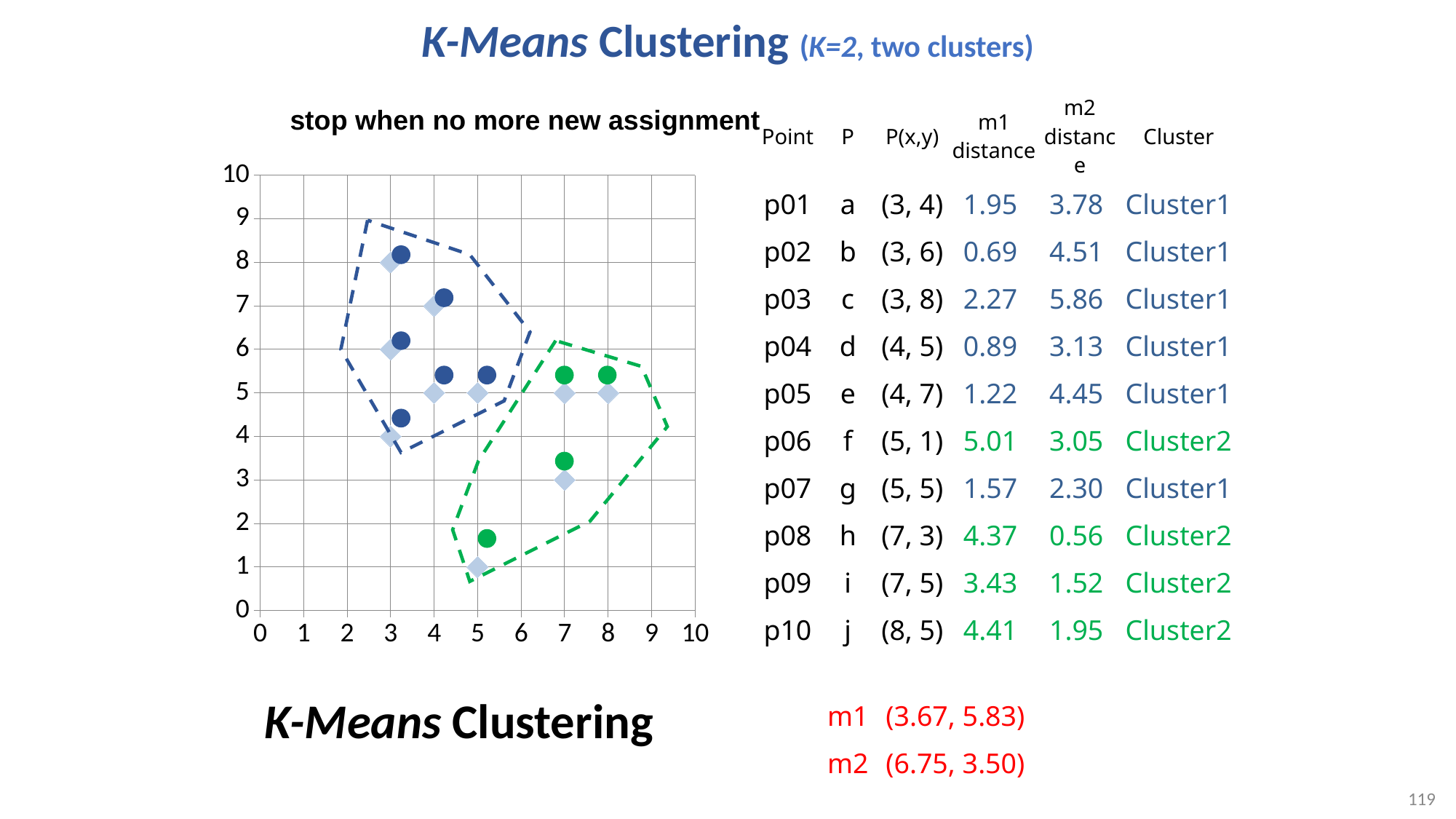
Which point has the lowest y value on the scatter chart? f (5, 1) Which point has the highest y value on the scatter chart? c (3, 8) What is the maximum value shown on the y axis of the scatter chart? 10 What kind of chart is shown on the left of the slide? scatter chart What are the coordinates of point c (p03) on the scatter chart? (3, 8) What are the coordinates of point j (p10) on the scatter chart? (8, 5) What is the difference in y value between point c (3, 8) and point a (3, 4)? 4 What is the maximum value shown on the x axis of the scatter chart? 10 What are the coordinates of point f (p06) on the scatter chart? (5, 1) Is the y value of point h (7, 3) greater or less than 5? less Which point has the largest x value on the scatter chart? j (8, 5) How many data points (light diamond markers) are plotted on the scatter chart? 10